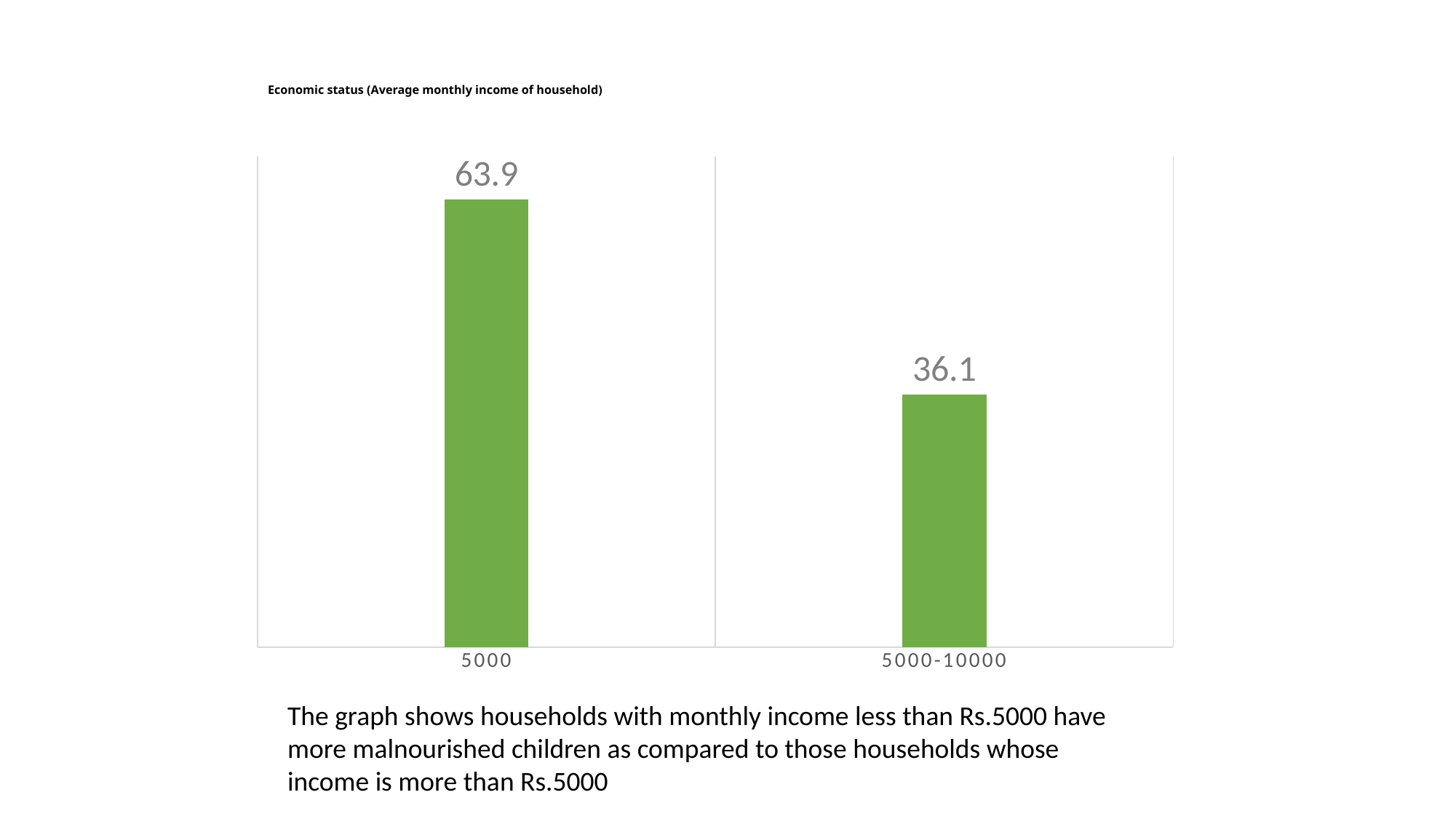
What kind of chart is shown on the slide? Bar chart Do the values rise or fall from left to right along the x axis? Fall Which category has the lowest value? 5000-10000 Which is larger, the value for 5000 or the value for 5000-10000? 5000 Which category has the highest value? 5000 What colour are the bars in the chart? Green What is the value for the 5000-10000 category? 36.1 How many categories are shown on the x axis? 2 What is the value for the 5000 category? 63.9 What is the title of the chart? Economic status (Average monthly income of household) What is the difference between the values for 5000 and 5000-10000? 27.8